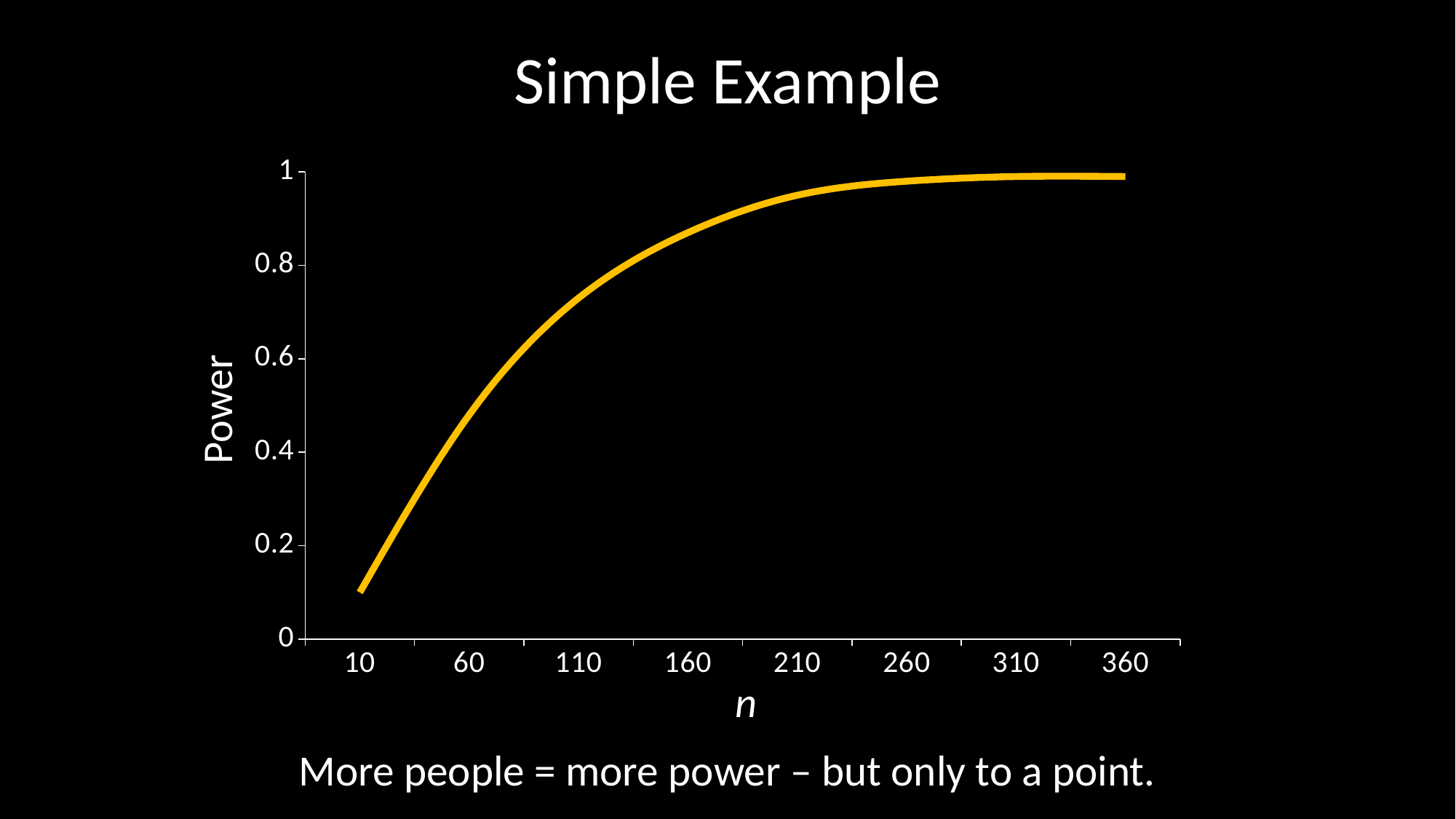
How many labelled tick values are shown on the x axis? 8 At which labelled n value is Power lowest? 10 Is the value of Power at n = 160 greater or less than 0.8? greater Which has the larger Power value, n = 60 or n = 210? n = 210 What is the label of the y axis? Power Is the value of Power at n = 60 greater or less than 0.4? greater Does Power rise or fall as n increases along the x axis? rise Is the value of Power at n = 10 greater or less than 0.2? less What is the title of the chart? Simple Example What kind of chart is shown on the slide? line chart